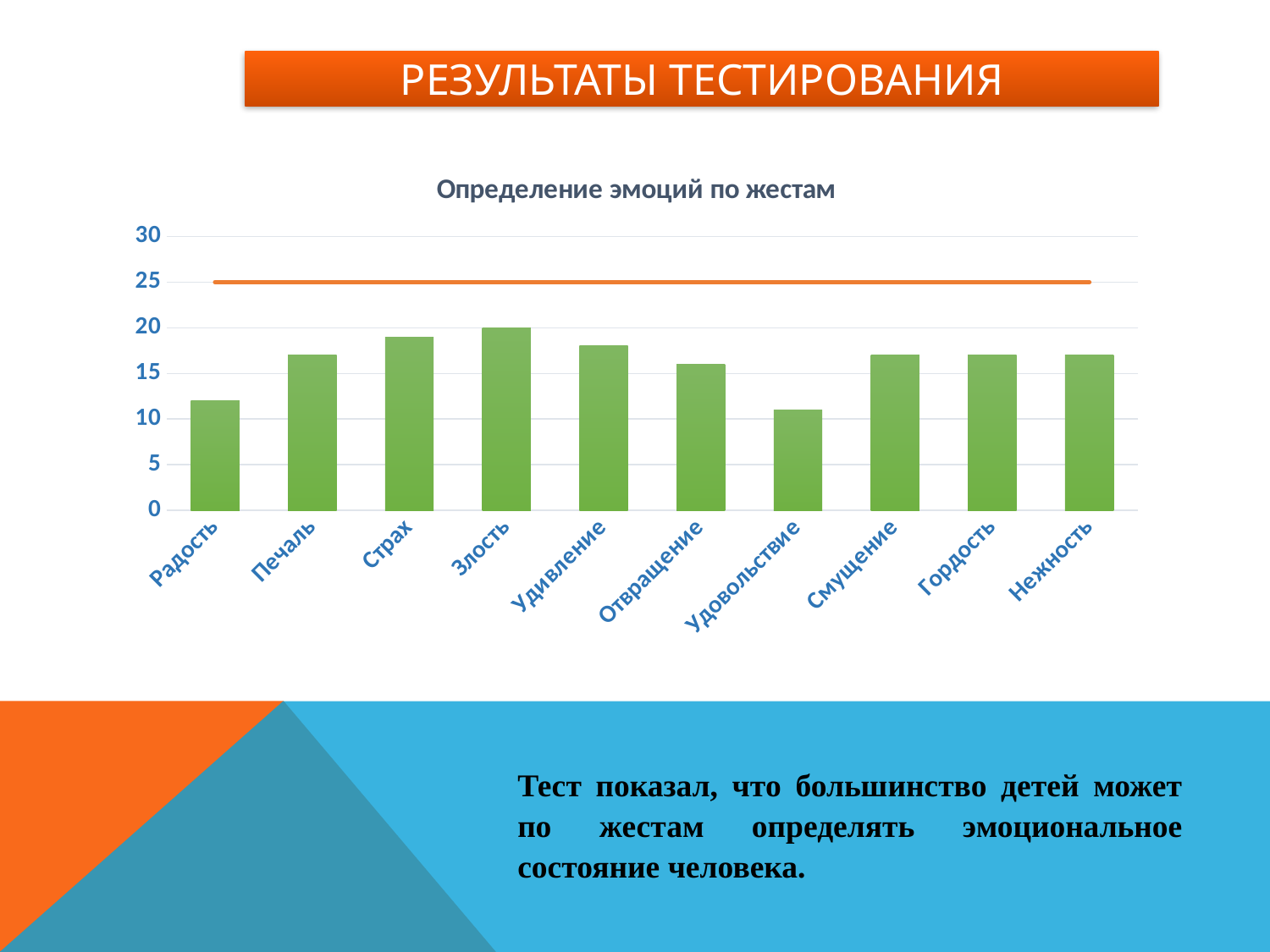
What kind of chart is shown on the slide? bar chart Is the value for Радость greater or less than 15? less Which category has the highest bar in the chart? Злость Is the value for Удивление greater or less than 20? less Is the value for Злость greater or less than 15? greater Which is larger, the value for Страх or the value for Радость? Страх How many categories are shown on the x axis of the chart? 10 What is the title of the chart? Определение эмоций по жестам Which category has the lowest bar in the chart? Удовольствие At what value on the y axis is the horizontal orange line drawn? 25 Which is larger, the value for Удовольствие or the value for Печаль? Печаль